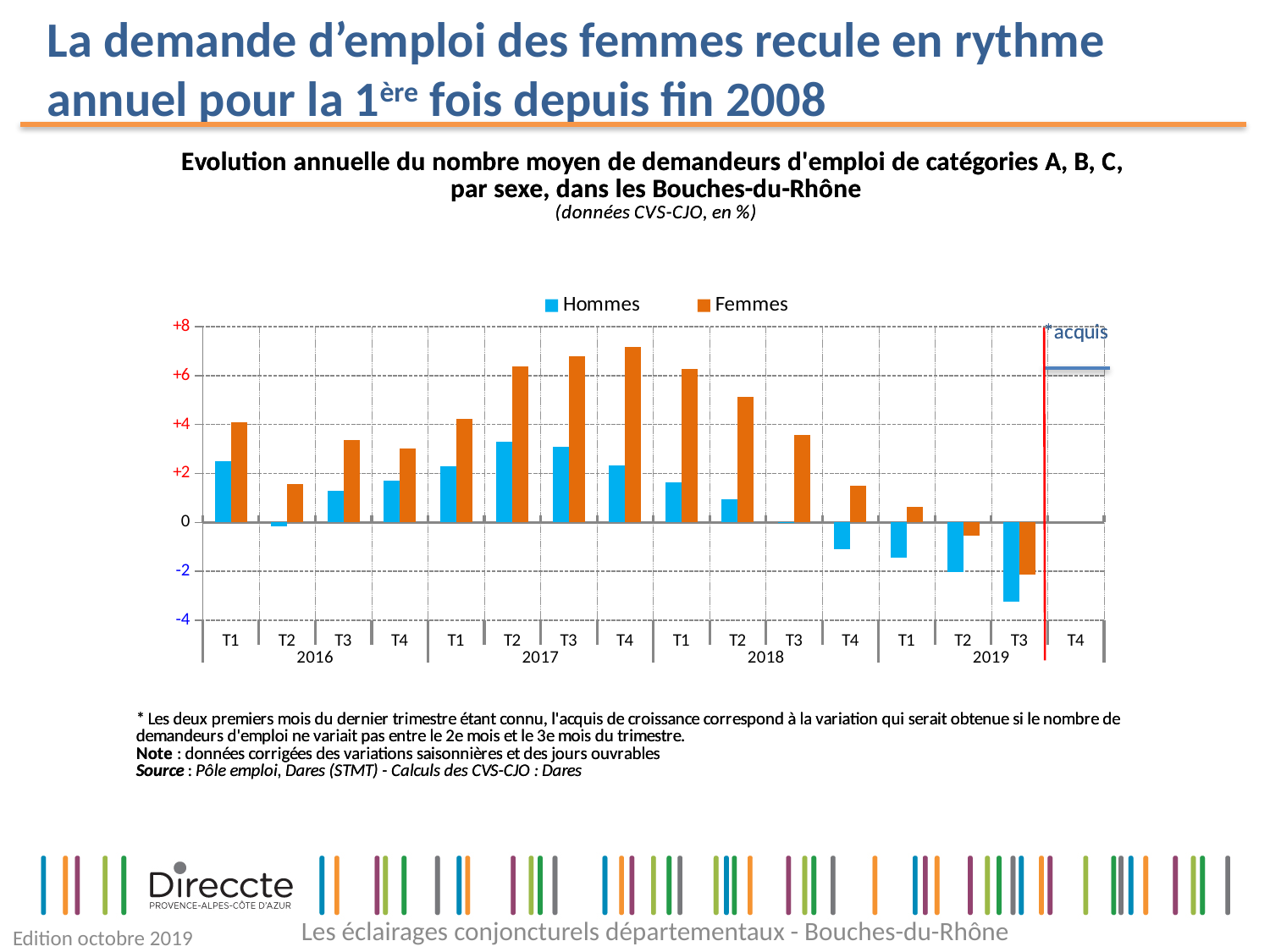
Which two series are listed in the chart legend? Hommes and Femmes In T1 2018, which series has the larger value, Hommes or Femmes? Femmes Is the value for Femmes in T2 2018 greater or less than +4? greater Which colour represents the Femmes series in the chart? orange Is the value for Femmes in T4 2017 greater or less than +6? greater What kind of chart is shown on the slide? bar chart In which quarter does the Femmes series reach its highest value? T4 2017 Does the Femmes series rise or fall from T4 2017 to T3 2019? fall How many series does the legend list? 2 How many quarters are labelled along the x axis of the chart? 16 In which quarter does the Hommes series reach its lowest value? T3 2019 Is the value for Hommes in T3 2019 greater or less than -2? less